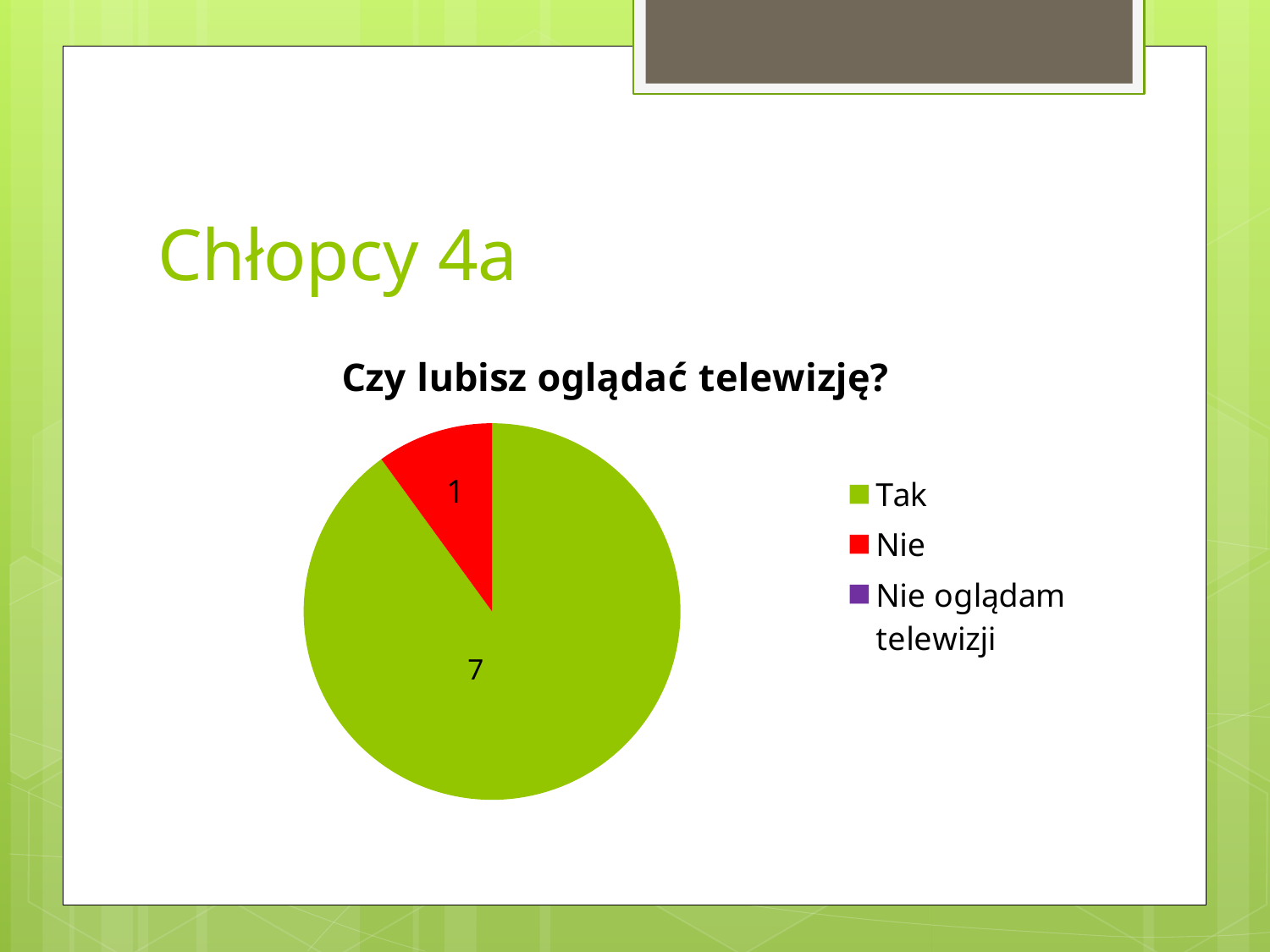
What colour is the "Nie" slice in the pie chart? Red Which category has the largest slice in the pie chart? Tak What is the value shown for the "Tak" slice in the pie chart? 7 What is the difference between the "Tak" value and the "Nie" value in the pie chart? 6 How many entries does the legend of the pie chart list? 3 What type of chart is shown on the slide? Pie chart What is the value shown for the "Nie" slice in the pie chart? 1 What is the title of the chart on the slide? Czy lubisz oglądać telewizję? Which is larger in the pie chart, the value for "Tak" or the value for "Nie"? Tak